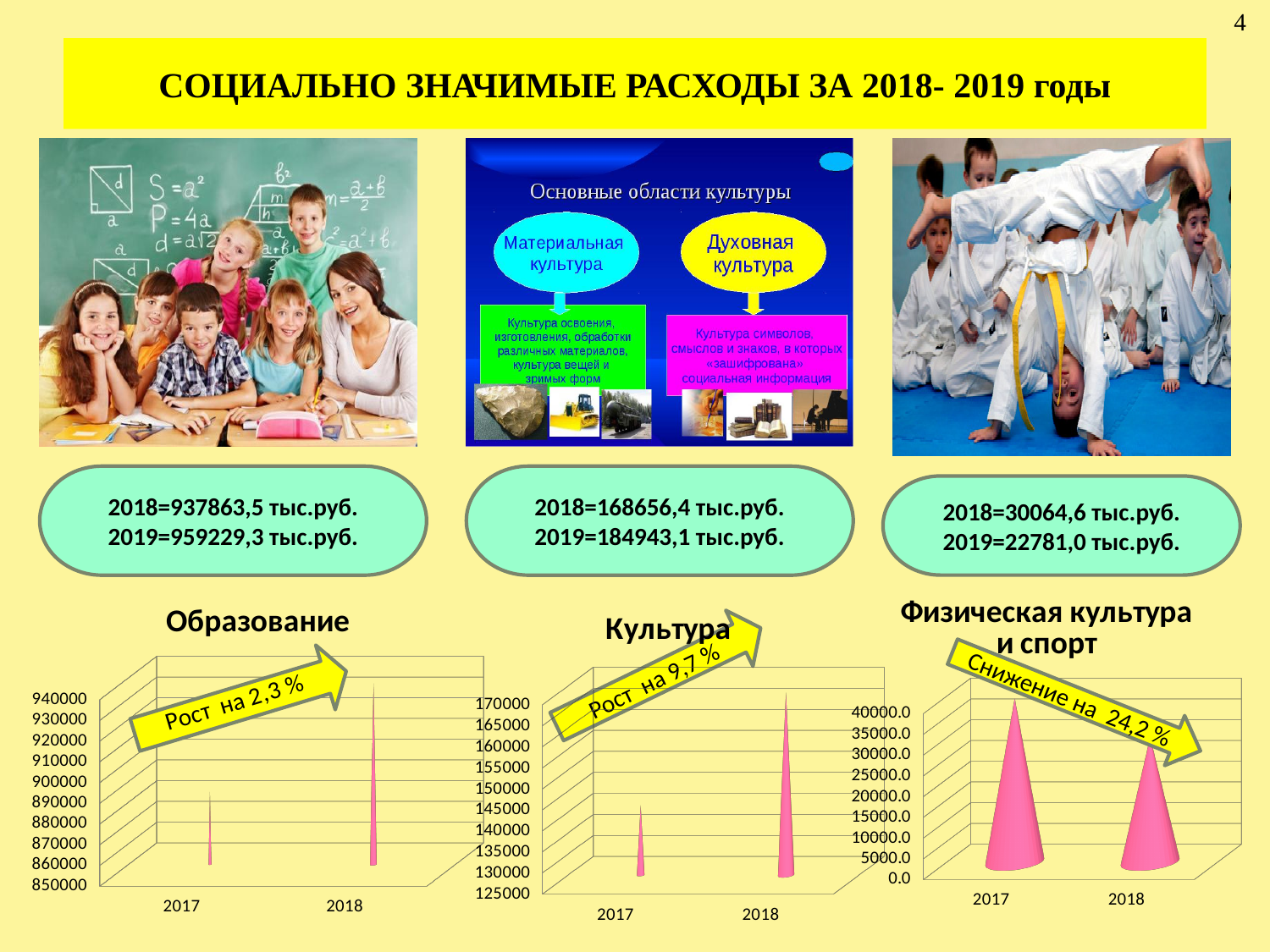
In the Образование chart, is the value for 2018 greater or less than 900000? greater In the Образование chart, do the values rise or fall from 2017 to 2018? rise In the Культура chart, which year has the higher value, 2017 or 2018? 2018 In the Физическая культура и спорт chart, which year has the lower value? 2018 In the Образование chart, which year has the higher value, 2017 or 2018? 2018 How many years are shown on the x axis of the Культура chart? 2 In the Физическая культура и спорт chart, is the value for 2017 greater or less than 25000.0? greater In the Культура chart, is the value for 2018 greater or less than 155000? greater What percentage change is written on the arrow over the Физическая культура и спорт chart? Снижение на 24,2 % In the Физическая культура и спорт chart, do the values rise or fall from 2017 to 2018? fall